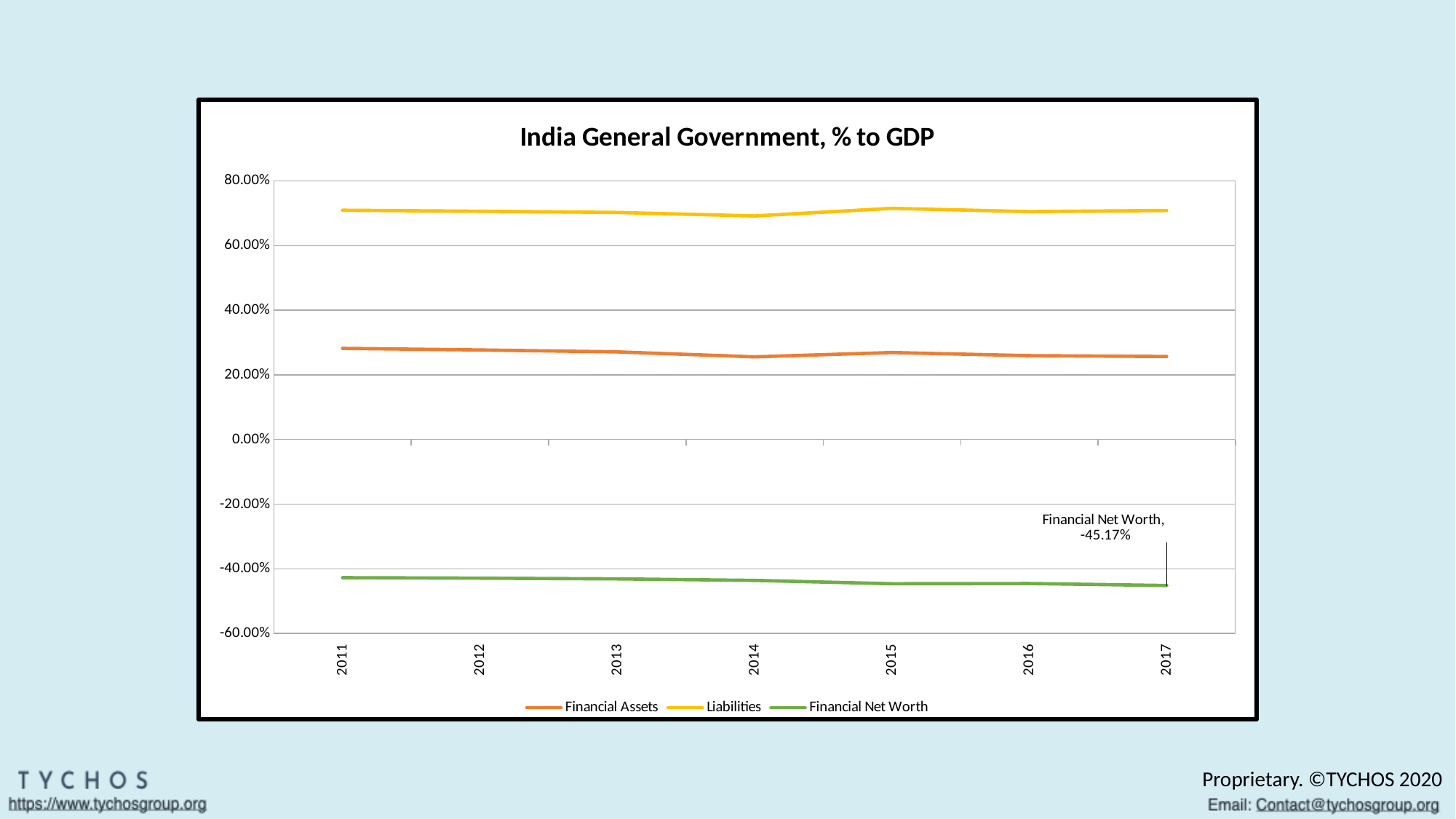
How many series does the legend list? 3 What is the title of the chart? India General Government, % to GDP Which is larger in 2015, Financial Assets or Liabilities? Liabilities Is the value for Financial Net Worth in 2011 greater or less than -20.00%? less How many years are shown on the x axis? 7 Which series has the lowest values across the chart? Financial Net Worth Does Financial Net Worth rise or fall from 2011 to 2017? fall What is the value of Financial Net Worth in 2017? -45.17% Is the value for Financial Assets in 2014 greater or less than 40.00%? less What kind of chart is shown on the slide? line chart Which series has the highest values across the chart? Liabilities Is the value for Liabilities in 2011 greater or less than 60.00%? greater